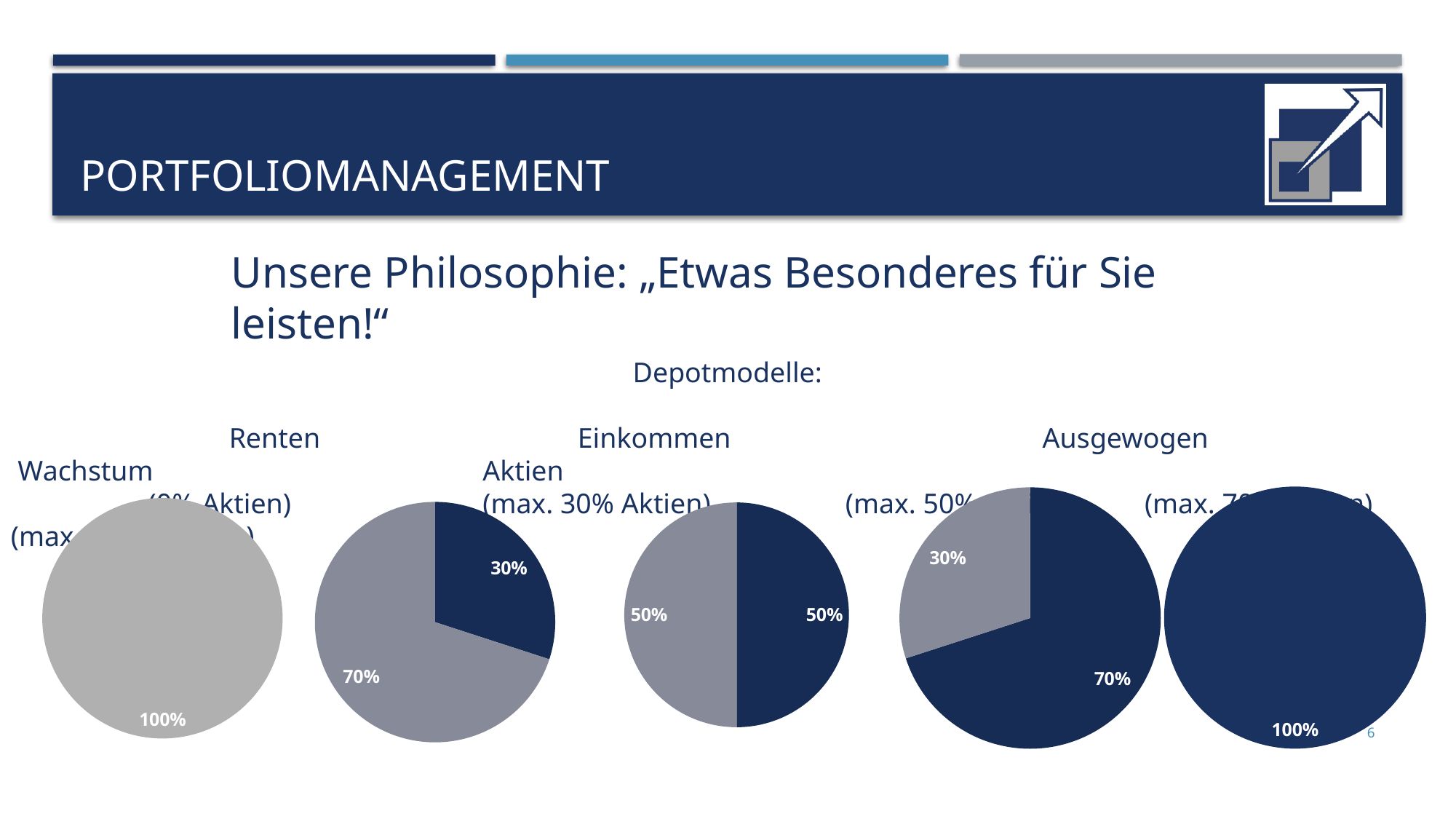
In the rightmost pie chart, what value is shown on the single slice? 100% What kind of charts are shown on the slide? Pie charts In the second pie chart from the left, what value is shown on the dark blue slice? 30% In the fourth pie chart from the left, what value is shown on the dark blue slice? 70% In the second pie chart from the left, which slice is larger, the dark blue one or the grey one? The grey one How many pie charts are on the slide? 5 In the leftmost pie chart, what value is shown on the single slice? 100% In the second pie chart from the left, what value is shown on the grey slice? 70% In the middle pie chart, what value is shown on each of the two slices? 50% How many slices does the middle pie chart have? 2 In the fourth pie chart from the left, what is the difference between the two slice values? 40% In the fourth pie chart from the left, what value is shown on the grey slice? 30%